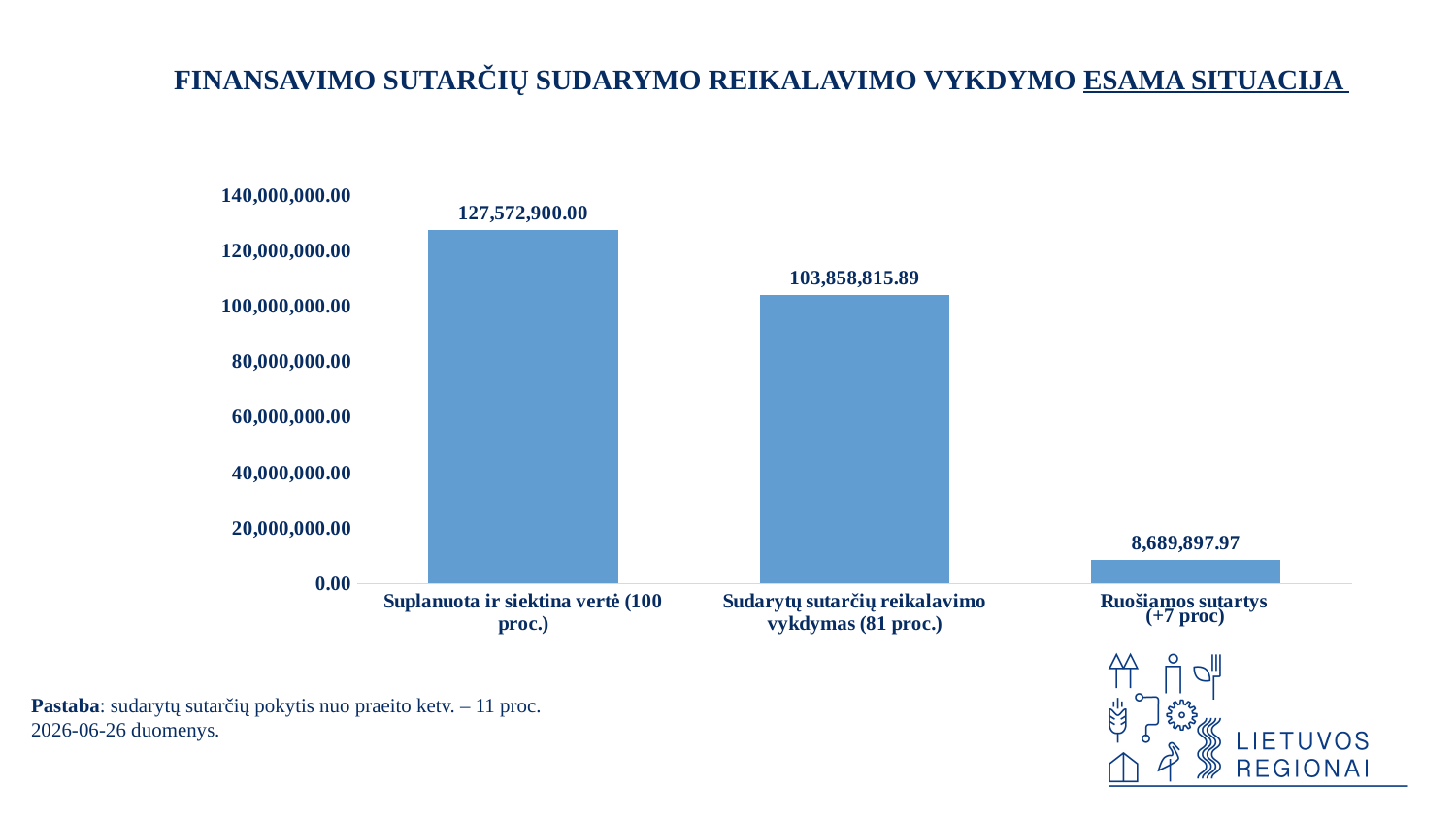
What kind of chart is shown on the slide? bar chart What is the value for "Sudarytų sutarčių reikalavimo vykdymas (81 proc.)"? 103,858,815.89 What is the difference between "Sudarytų sutarčių reikalavimo vykdymas (81 proc.)" and "Ruošiamos sutartys (+7 proc)"? 95,168,917.92 How many categories are shown in the chart? 3 Is the value for "Sudarytų sutarčių reikalavimo vykdymas (81 proc.)" greater or less than 100,000,000.00? greater Which category has the highest value? Suplanuota ir siektina vertė (100 proc.) What is the difference between "Suplanuota ir siektina vertė (100 proc.)" and "Sudarytų sutarčių reikalavimo vykdymas (81 proc.)"? 23,714,084.11 What is the value for "Ruošiamos sutartys (+7 proc)"? 8,689,897.97 Which category has the lowest value? Ruošiamos sutartys (+7 proc) Which is larger: "Sudarytų sutarčių reikalavimo vykdymas (81 proc.)" or "Ruošiamos sutartys (+7 proc)"? Sudarytų sutarčių reikalavimo vykdymas (81 proc.) Do the values rise or fall from left to right across the categories? fall What is the value for "Suplanuota ir siektina vertė (100 proc.)"? 127,572,900.00